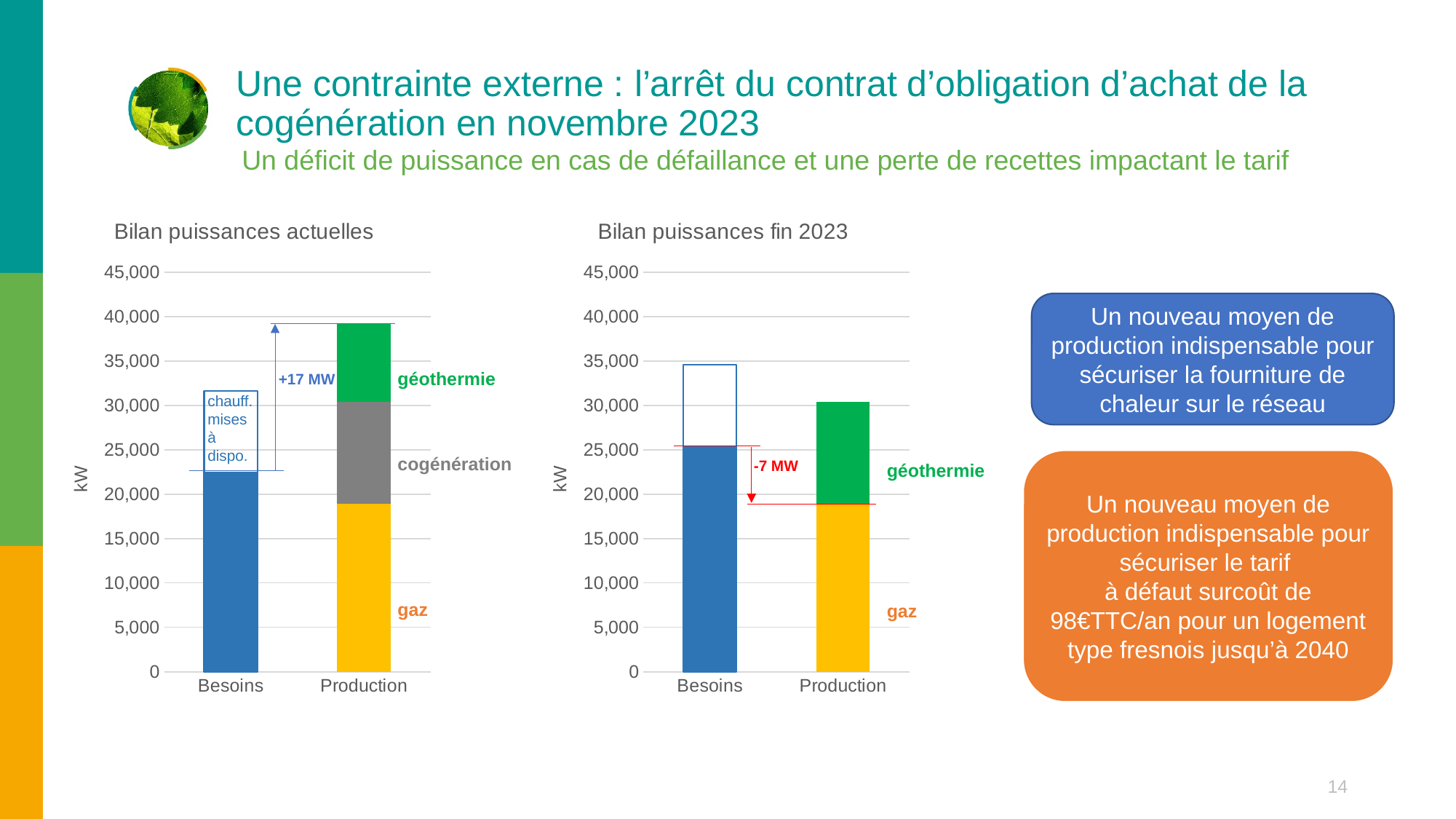
In the 'Bilan puissances actuelles' chart, what surplus is annotated between Besoins and Production? +17 MW In the 'Bilan puissances fin 2023' chart, is the total Production bar greater or less than 35,000? less What kind of chart is the 'Bilan puissances actuelles' chart? Stacked bar chart In the 'Bilan puissances fin 2023' chart, what deficit is annotated between Besoins and Production? -7 MW In the 'Bilan puissances actuelles' chart, which bar is taller, Besoins or Production? Production In the 'Bilan puissances actuelles' chart, which segments make up the Production bar? gaz, cogénération, géothermie In the 'Bilan puissances actuelles' chart, is the total Production bar greater or less than 35,000? greater What unit is shown on the y axis of the 'Bilan puissances actuelles' chart? kW Which segment is missing from the Production bar in the 'Bilan puissances fin 2023' chart compared with the 'Bilan puissances actuelles' chart? cogénération In the 'Bilan puissances actuelles' chart, is the filled Besoins bar greater or less than 25,000? less How many categories are shown on the x axis of the 'Bilan puissances fin 2023' chart? 2